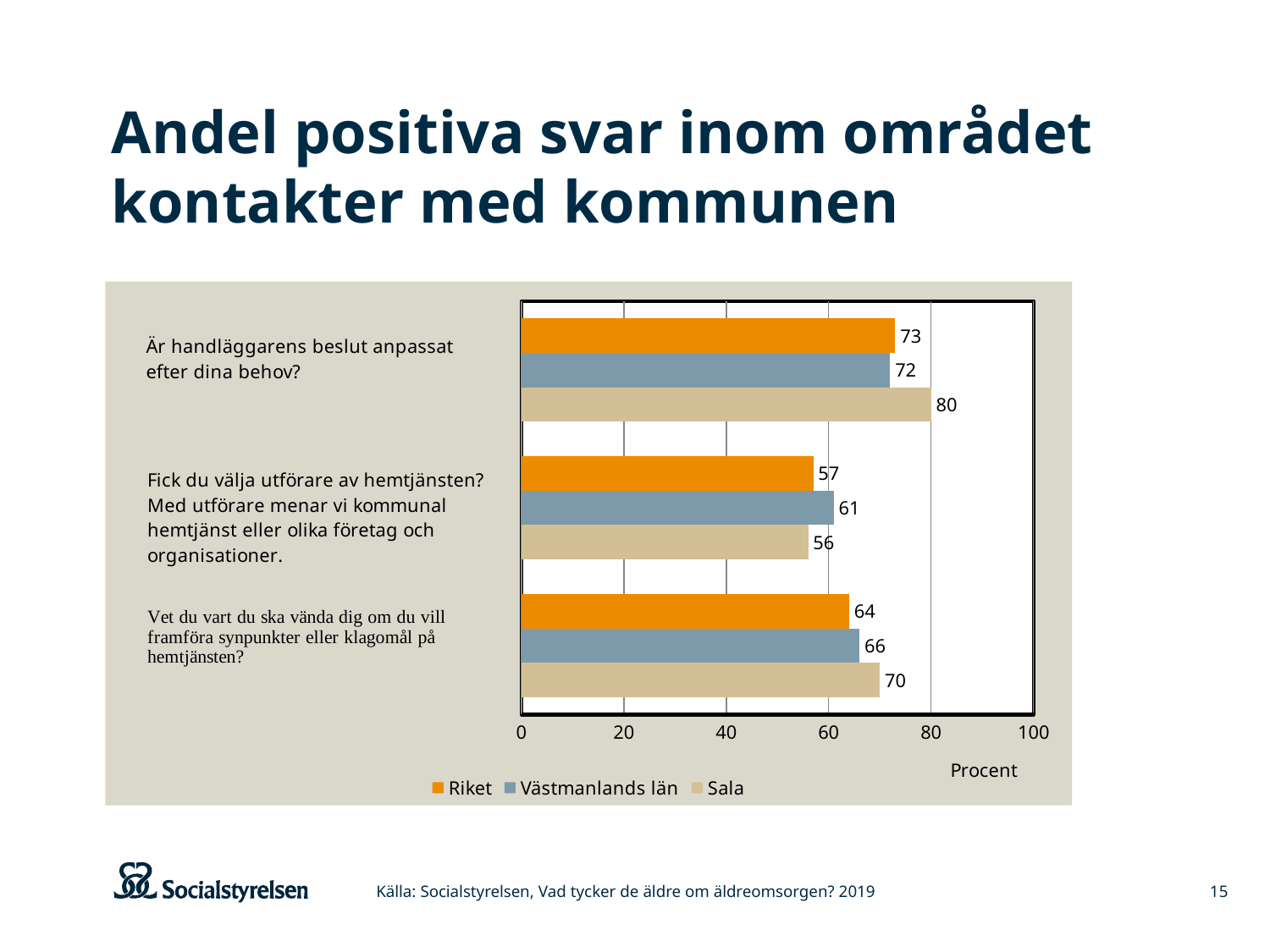
What is the value for Sala on the question "Är handläggarens beslut anpassat efter dina behov?"? 80 Which series has the highest value on the question "Är handläggarens beslut anpassat efter dina behov?"? Sala On the question "Fick du välja utförare av hemtjänsten?", which is larger: Västmanlands län or Riket? Västmanlands län What is the value for Riket on the question "Fick du välja utförare av hemtjänsten?"? 57 Which series has the lowest value on the question "Fick du välja utförare av hemtjänsten?"? Sala What is the difference between Sala and Riket on the question "Vet du vart du ska vända dig om du vill framföra synpunkter eller klagomål på hemtjänsten?"? 6 What kind of chart is shown on the slide? Bar chart How many questions (categories) are shown in the chart? 3 Is the value for Sala on the question "Fick du välja utförare av hemtjänsten?" greater or less than 60? less What is the value for Västmanlands län on the question "Vet du vart du ska vända dig om du vill framföra synpunkter eller klagomål på hemtjänsten?"? 66 What is the difference between Sala and Riket on the question "Är handläggarens beslut anpassat efter dina behov?"? 7 How many series does the legend list? 3